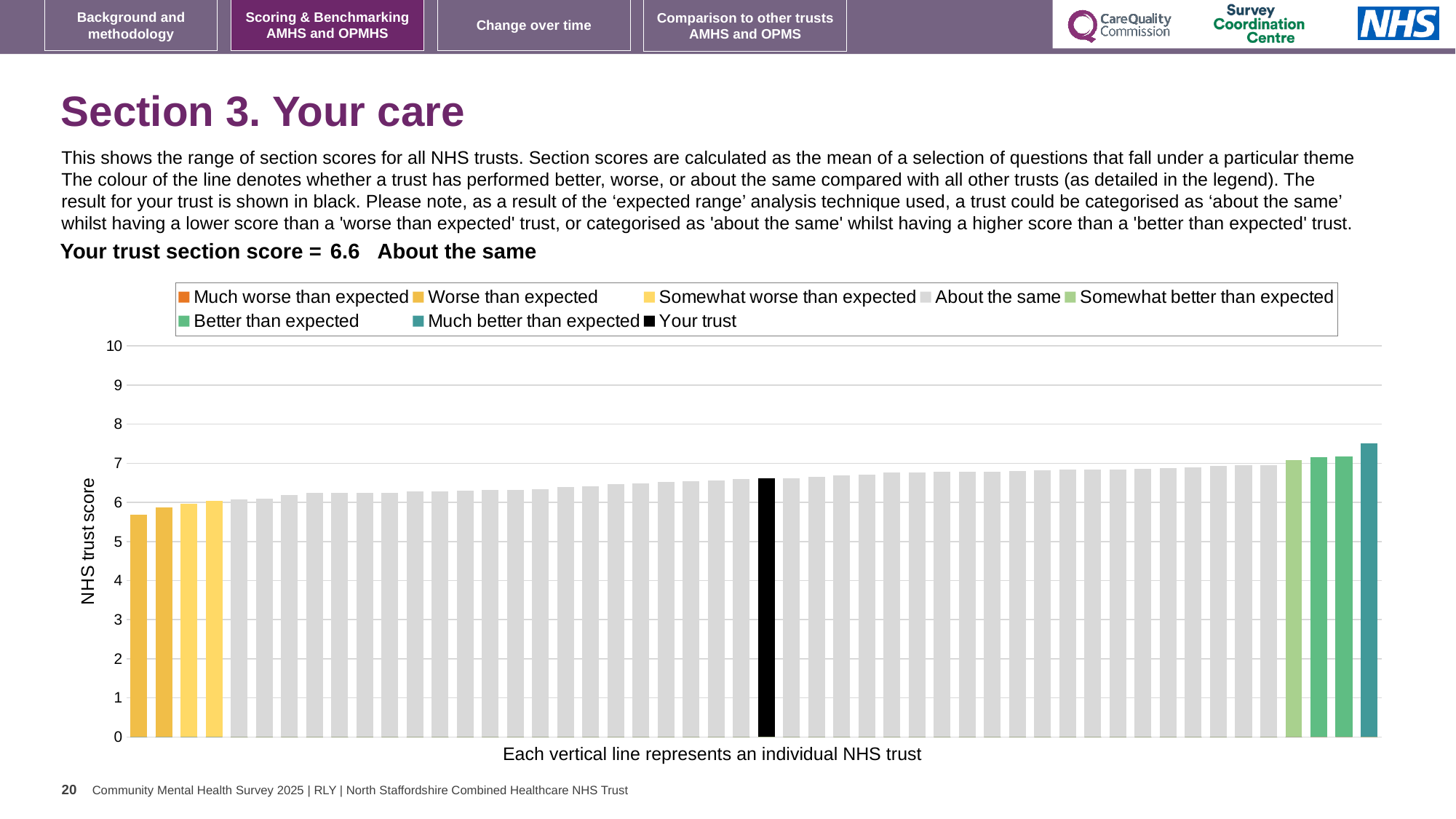
Is the value of the rightmost (highest) bar greater or less than 7? greater Is the value of the black 'Your trust' bar greater or less than 7? less What is the section score for your trust (the black bar)? 6.6 What kind of chart is shown on the slide? bar chart What is the label on the vertical axis of the chart? NHS trust score How many entries does the chart legend list? 8 Which is taller, the leftmost bar or the rightmost bar? the rightmost bar Do the bar values rise or fall from left to right across the chart? rise Which legend category does the tallest bar in the chart belong to? Much better than expected How many bars are coloured in the 'Much better than expected' (teal) colour? 1 Is the value of the black 'Your trust' bar greater or less than 6? greater